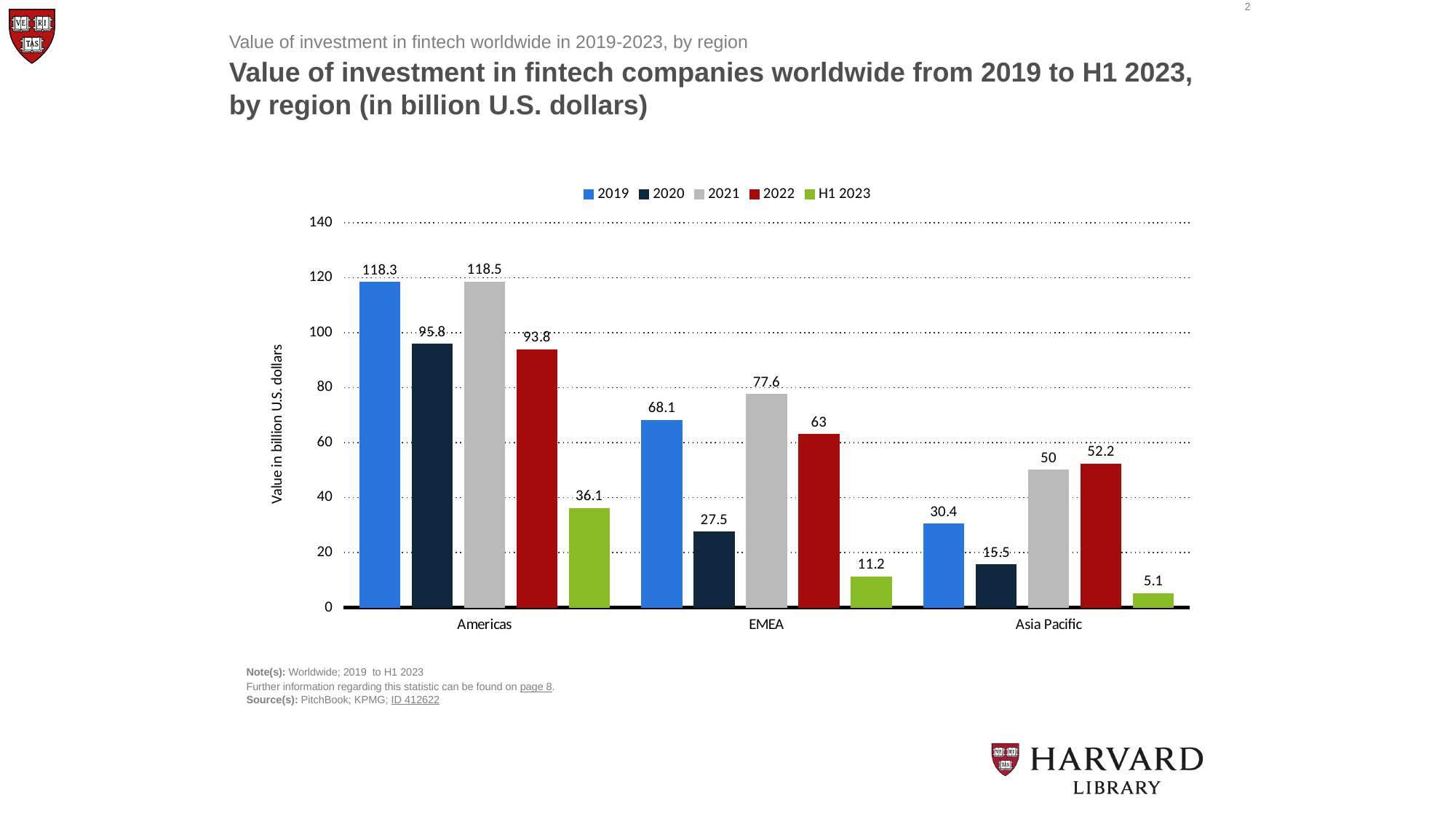
How many regions are shown on the x axis? 3 Is the 2020 value for the Americas greater or less than 80? greater How many series does the legend list? 5 What is the label of the y axis? Value in billion U.S. dollars What was the value of fintech investment in the Americas in 2019? 118.3 Which region had the lowest fintech investment value in 2020? Asia Pacific What was the value of fintech investment in EMEA in 2021? 77.6 Which region had the highest fintech investment value in 2022? Americas What is the difference between the 2021 and 2022 values for EMEA? 14.6 What kind of chart is shown on the slide? Bar chart What was the value of fintech investment in Asia Pacific in H1 2023? 5.1 Which is larger: the 2021 value for Asia Pacific or the 2022 value for Asia Pacific? 2022